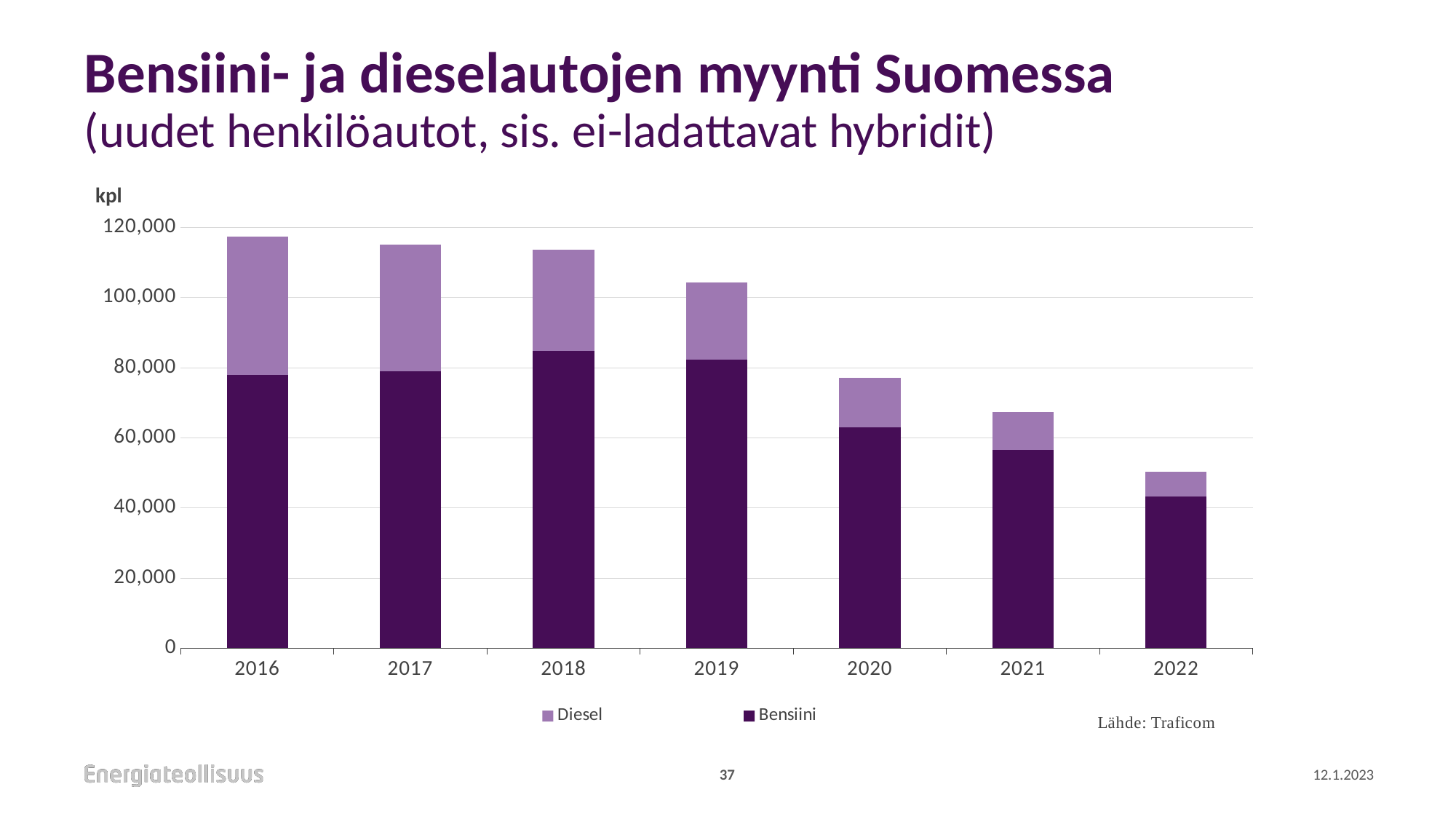
Which is larger, the total bar for 2019 or the total bar for 2020? 2019 Which year has the highest total bar in the chart? 2016 How many series does the chart's legend list? 2 Which year has the lowest total bar in the chart? 2022 What unit label is shown above the y axis of the chart? kpl What kind of chart is shown on the slide? bar chart Is the total bar for 2022 greater or less than 60,000? less Is the total bar for 2016 greater or less than 100,000? greater Do the total bar heights rise or fall from 2016 to 2022? fall Is the Bensiini value for 2021 greater or less than 60,000? less How many years are shown on the x axis of the chart? 7